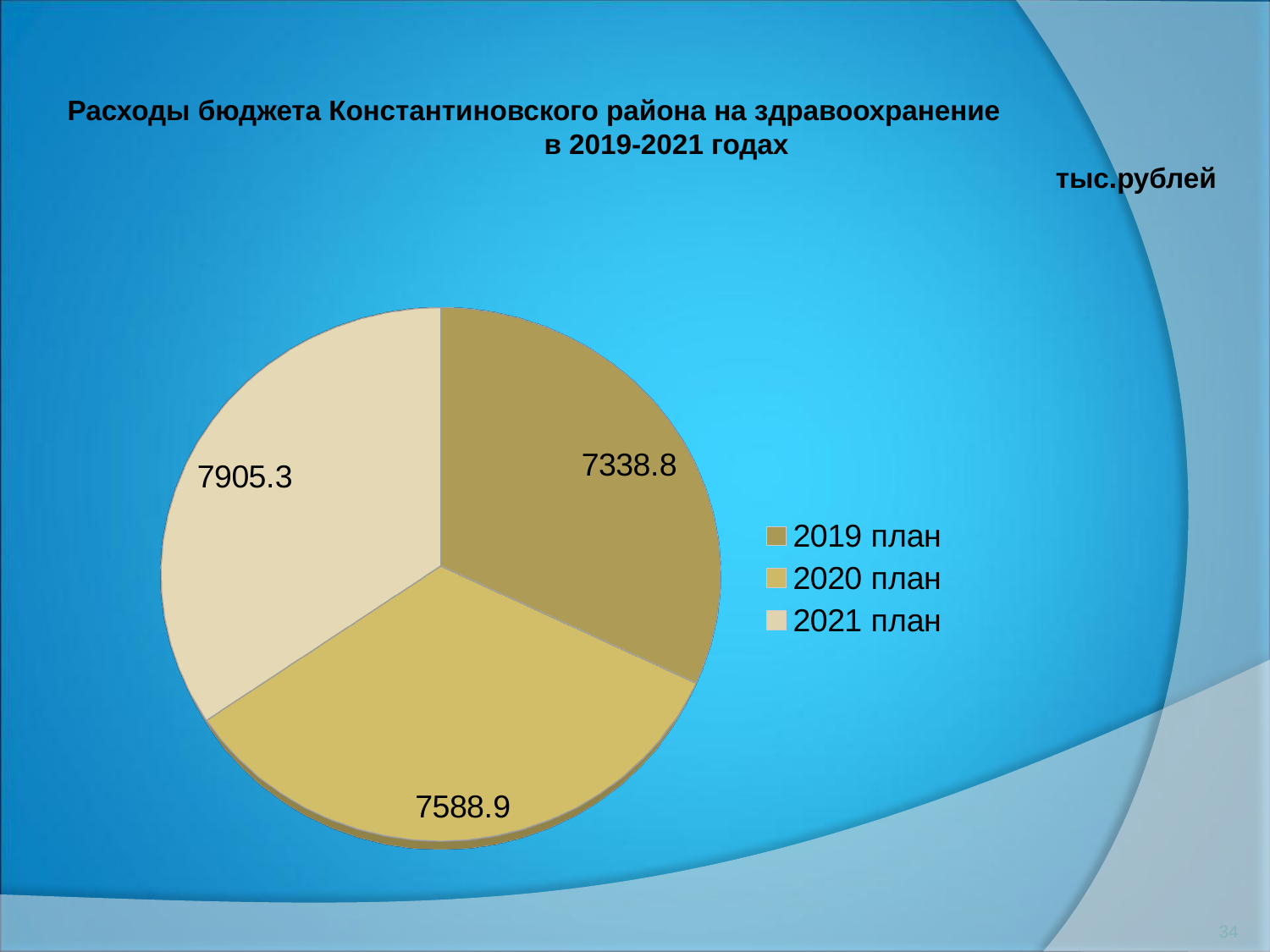
Do the planned healthcare expenditures rise or fall from 2019 to 2021? Rise What is the value shown for the 2021 план slice? 7905.3 What is the value shown for the 2020 план slice? 7588.9 Which is larger, the 2020 план value or the 2021 план value? 2021 план Which year has the smallest planned healthcare expenditure? 2019 план What is the planned healthcare expenditure for 2019 (2019 план)? 7338.8 How many slices does the pie chart have? 3 What is the difference between the 2020 план and 2019 план values? 250.1 Which year has the largest planned healthcare expenditure? 2021 план What is the difference between the 2021 план and 2019 план values? 566.5 In what units are the values on the chart expressed? тыс.рублей What type of chart is shown on the slide? Pie chart